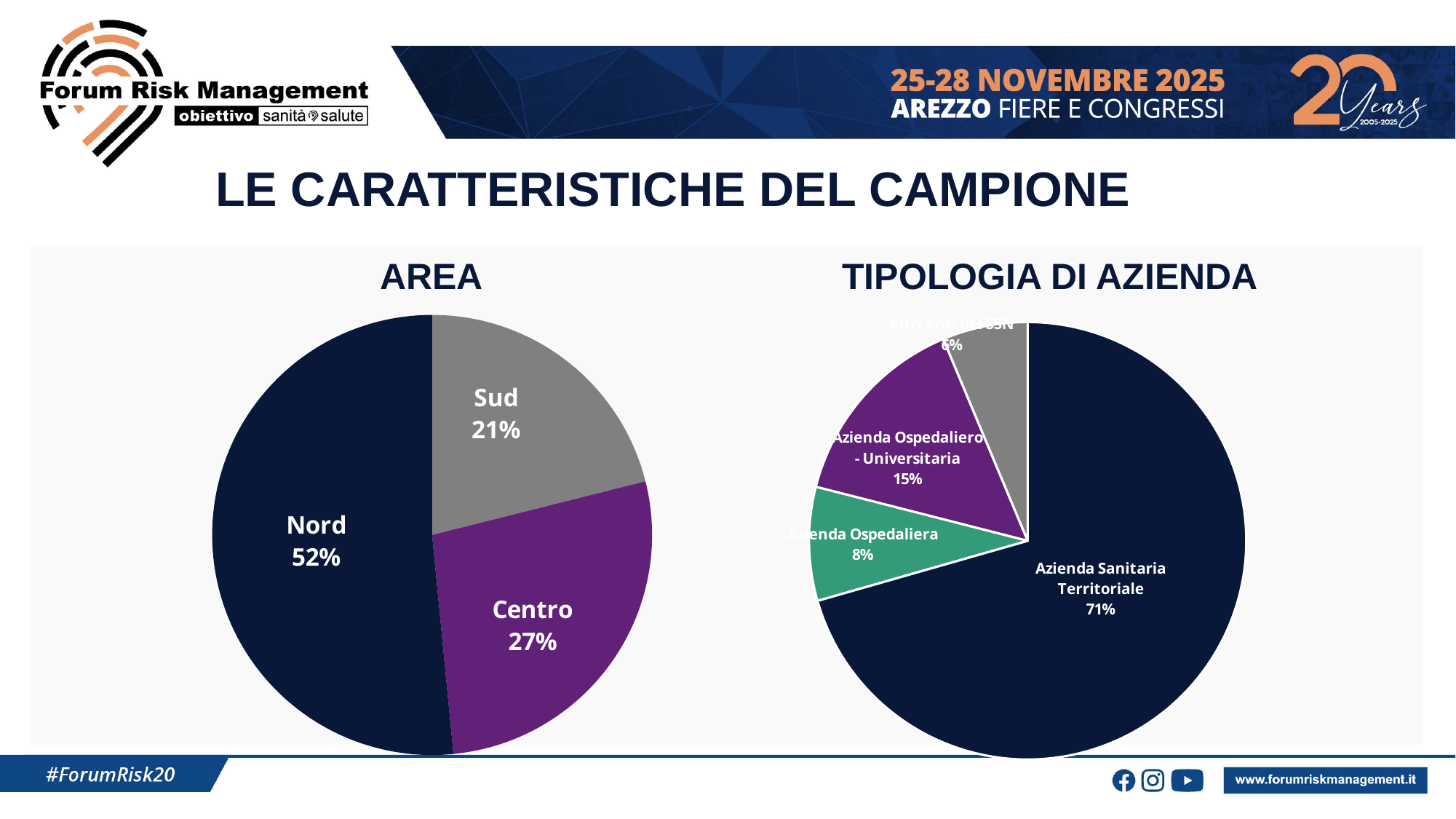
In the AREA chart, what share does Nord have? 52% In the TIPOLOGIA DI AZIENDA chart, what percentage is shown for Azienda Ospedaliero - Universitaria? 15% In the AREA chart, which area has the largest share? Nord In the AREA chart, what percentage is shown for Sud? 21% In the AREA chart, what percentage is shown for Centro? 27% In the TIPOLOGIA DI AZIENDA chart, what share does Azienda Sanitaria Territoriale have? 71% In the AREA chart, how many slices does the pie have? 3 In the AREA chart, what is the difference in percentage points between Nord and Centro? 25 In the TIPOLOGIA DI AZIENDA chart, which is larger: Azienda Ospedaliera or Azienda Ospedaliero - Universitaria? Azienda Ospedaliero - Universitaria In the TIPOLOGIA DI AZIENDA chart, how many categories are shown? 4 In the AREA chart, which area has the smallest share? Sud What type of chart is the TIPOLOGIA DI AZIENDA chart? Pie chart